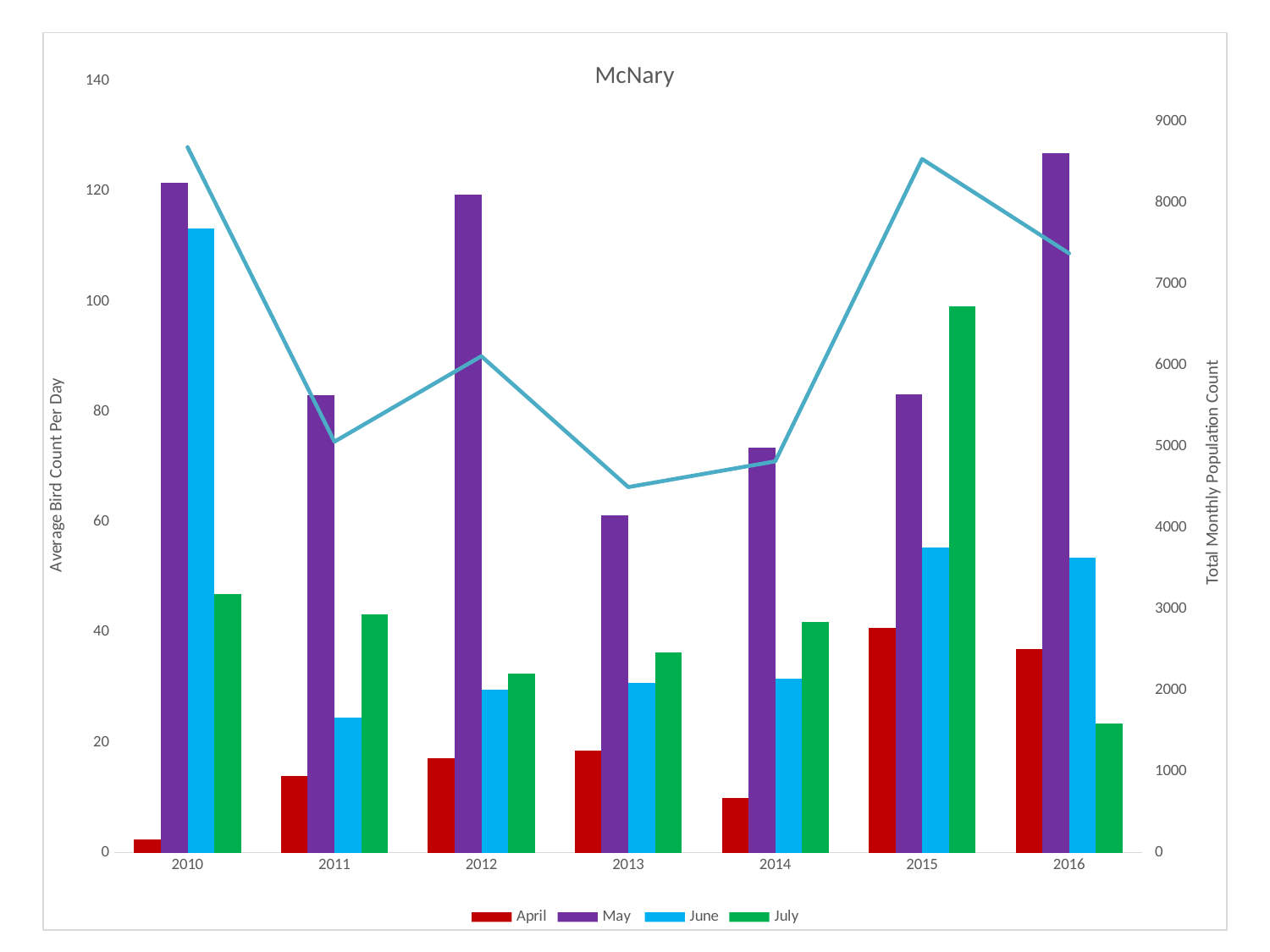
Is the value for May in 2012 greater or less than 100? greater In which year is the April bar the lowest? 2010 In which year is the July bar the highest? 2015 How many series does the legend list? 4 Is the value for July in 2016 greater or less than 40? less In which year is the June bar the lowest? 2011 What is the title of the chart? McNary Does the line plotted against the right-hand axis rise or fall from 2010 to 2013? fall What kind of chart is used to plot the April, May, June and July series? bar chart How many years are shown on the x axis? 7 Which is larger, the May bar for 2013 or the May bar for 2014? 2014 In which year is the May bar the highest? 2016